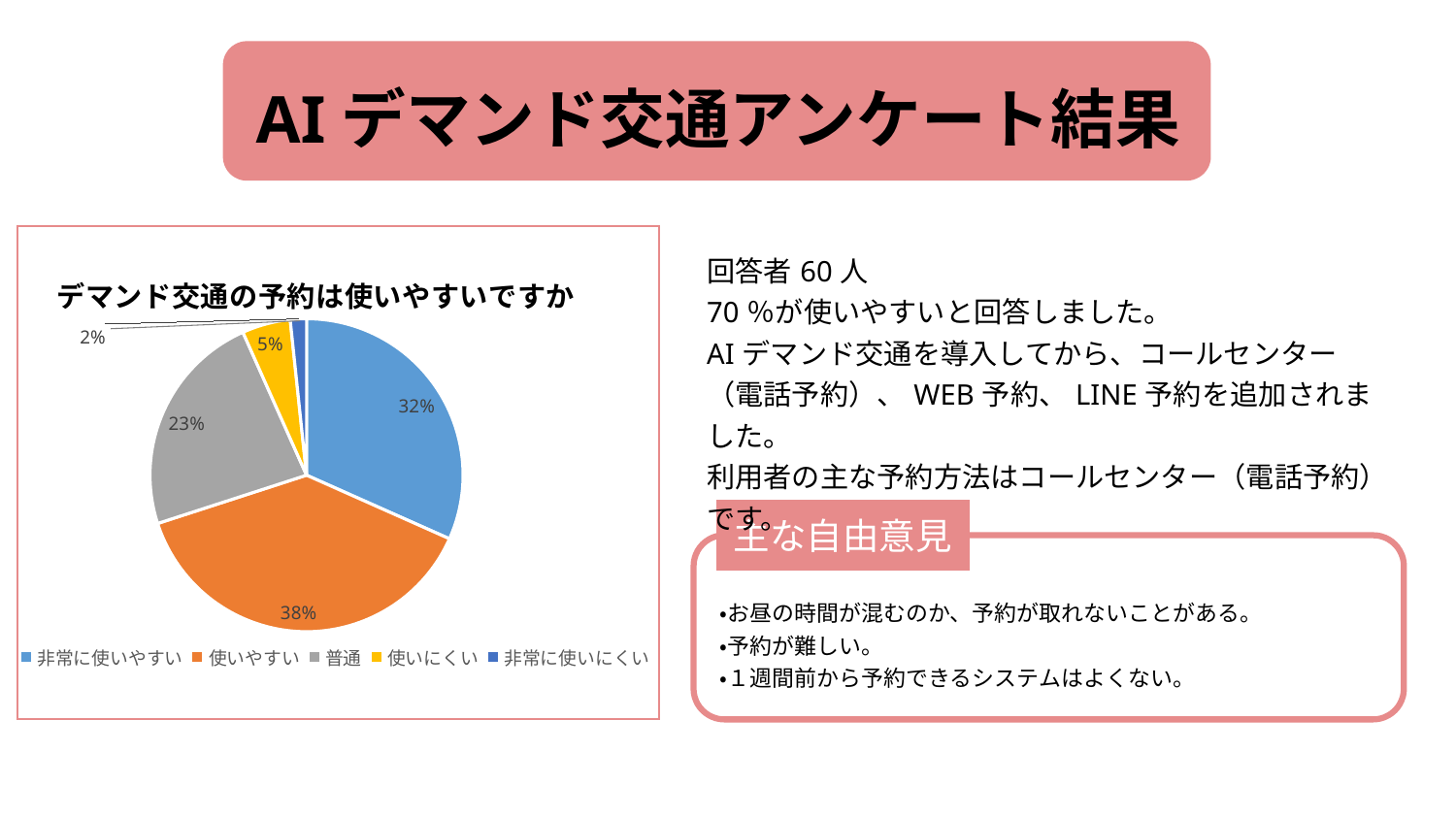
What percentage of respondents answered 使いにくい? 5% What is the difference in percentage points between 使いやすい and 非常に使いやすい? 6 Which is larger, the share for 普通 or the share for 使いにくい? 普通 What type of chart is shown on the slide? pie chart What percentage of respondents answered 非常に使いにくい? 2% Which response category has the smallest share of the pie? 非常に使いにくい How many categories does the legend list? 5 What percentage of respondents answered 普通? 23% What percentage of respondents answered 非常に使いやすい? 32% What is the title of the chart? デマンド交通の予約は使いやすいですか What percentage of respondents answered 使いやすい? 38% Which response category has the largest share of the pie? 使いやすい